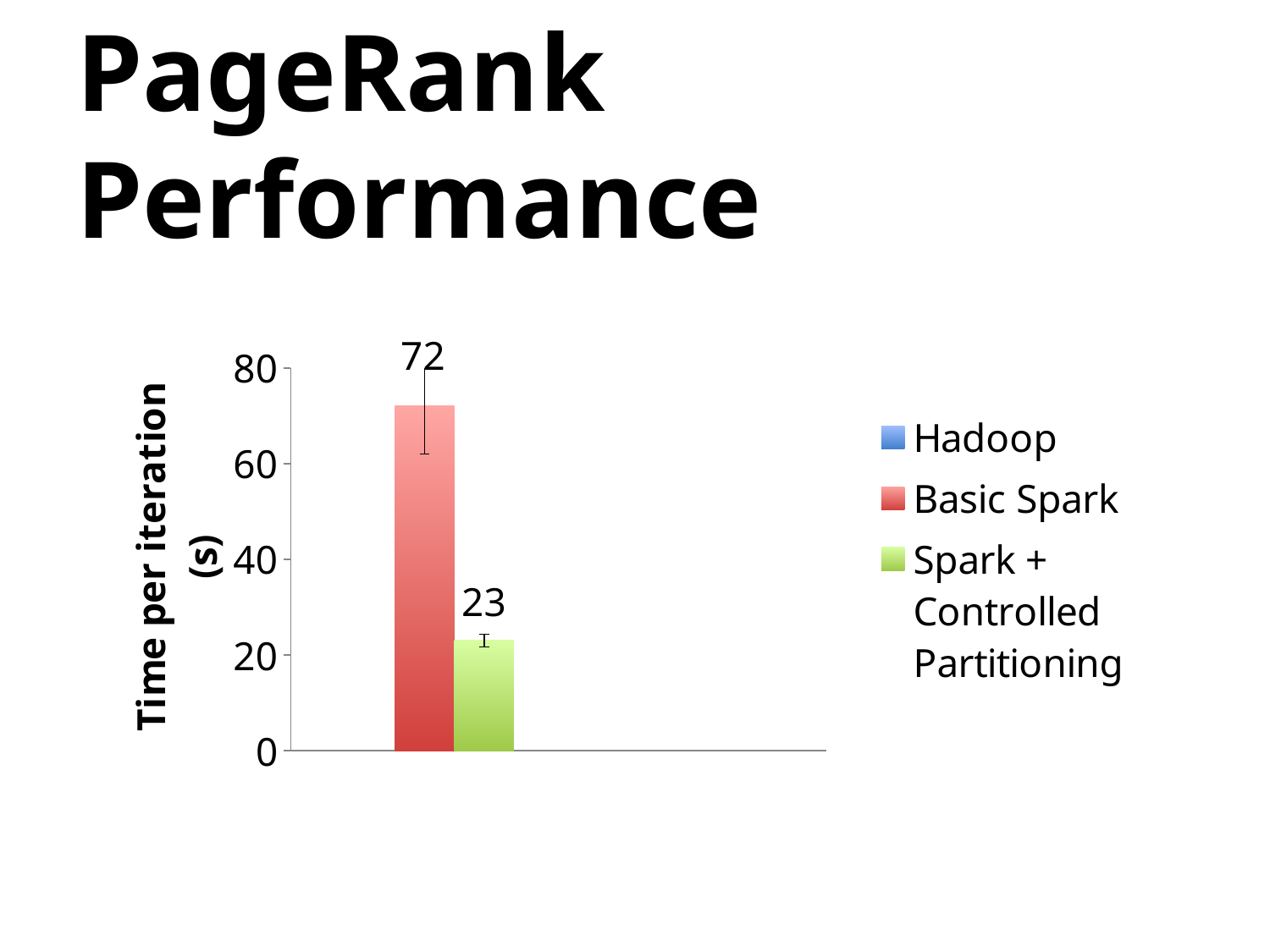
What kind of chart is shown on the slide? Bar chart Which series has the lowest time per iteration among the plotted bars? Spark + Controlled Partitioning Is the value for Spark + Controlled Partitioning greater or less than 40? less What is the difference in time per iteration between Basic Spark and Spark + Controlled Partitioning? 49 Which has a larger time per iteration, Basic Spark or Spark + Controlled Partitioning? Basic Spark What is the time per iteration for Basic Spark? 72 How many series does the legend list? 3 What is the time per iteration for Spark + Controlled Partitioning? 23 What colour is the Basic Spark bar? Red Is the value for Basic Spark greater or less than 60? greater Which series has the highest time per iteration among the plotted bars? Basic Spark What is the label of the vertical axis? Time per iteration (s)